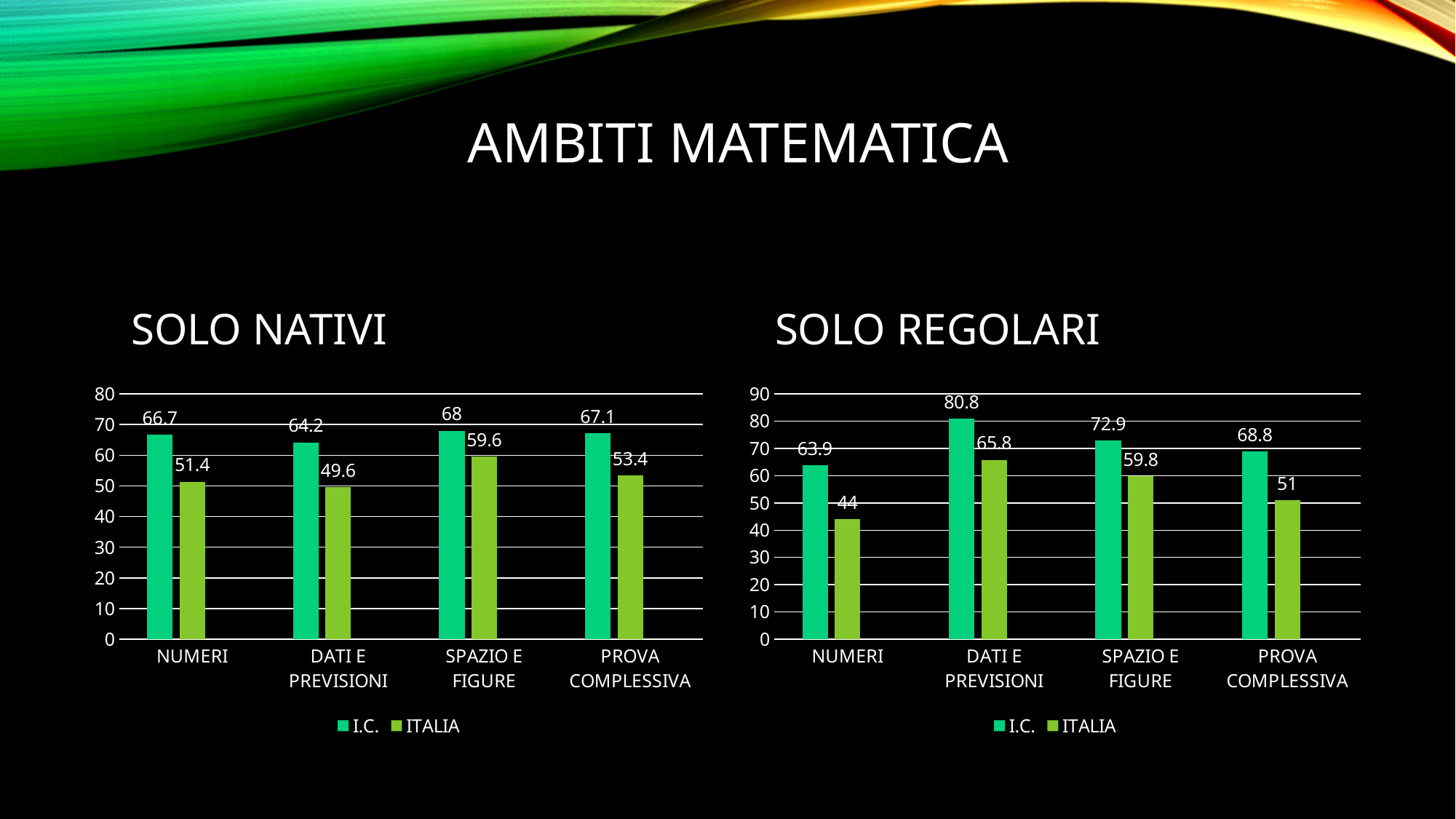
In the SOLO NATIVI chart, what is the ITALIA value for SPAZIO E FIGURE? 59.6 In the SOLO NATIVI chart, which category has the lowest ITALIA value? DATI E PREVISIONI In the SOLO REGOLARI chart, what is the I.C. value for DATI E PREVISIONI? 80.8 In the SOLO NATIVI chart, what is the I.C. value for NUMERI? 66.7 In the SOLO REGOLARI chart, which is larger for PROVA COMPLESSIVA: I.C. or ITALIA? I.C. In the SOLO REGOLARI chart, what is the difference between the I.C. and ITALIA values for SPAZIO E FIGURE? 13.1 In the SOLO REGOLARI chart, which category has the highest I.C. value? DATI E PREVISIONI In the SOLO NATIVI chart, what is the difference between the I.C. and ITALIA values for PROVA COMPLESSIVA? 13.7 How many series does the legend of the SOLO REGOLARI chart list? 2 How many categories are shown on the x axis of the SOLO NATIVI chart? 4 What type of chart is the SOLO NATIVI chart? Bar chart In the SOLO REGOLARI chart, what is the ITALIA value for NUMERI? 44